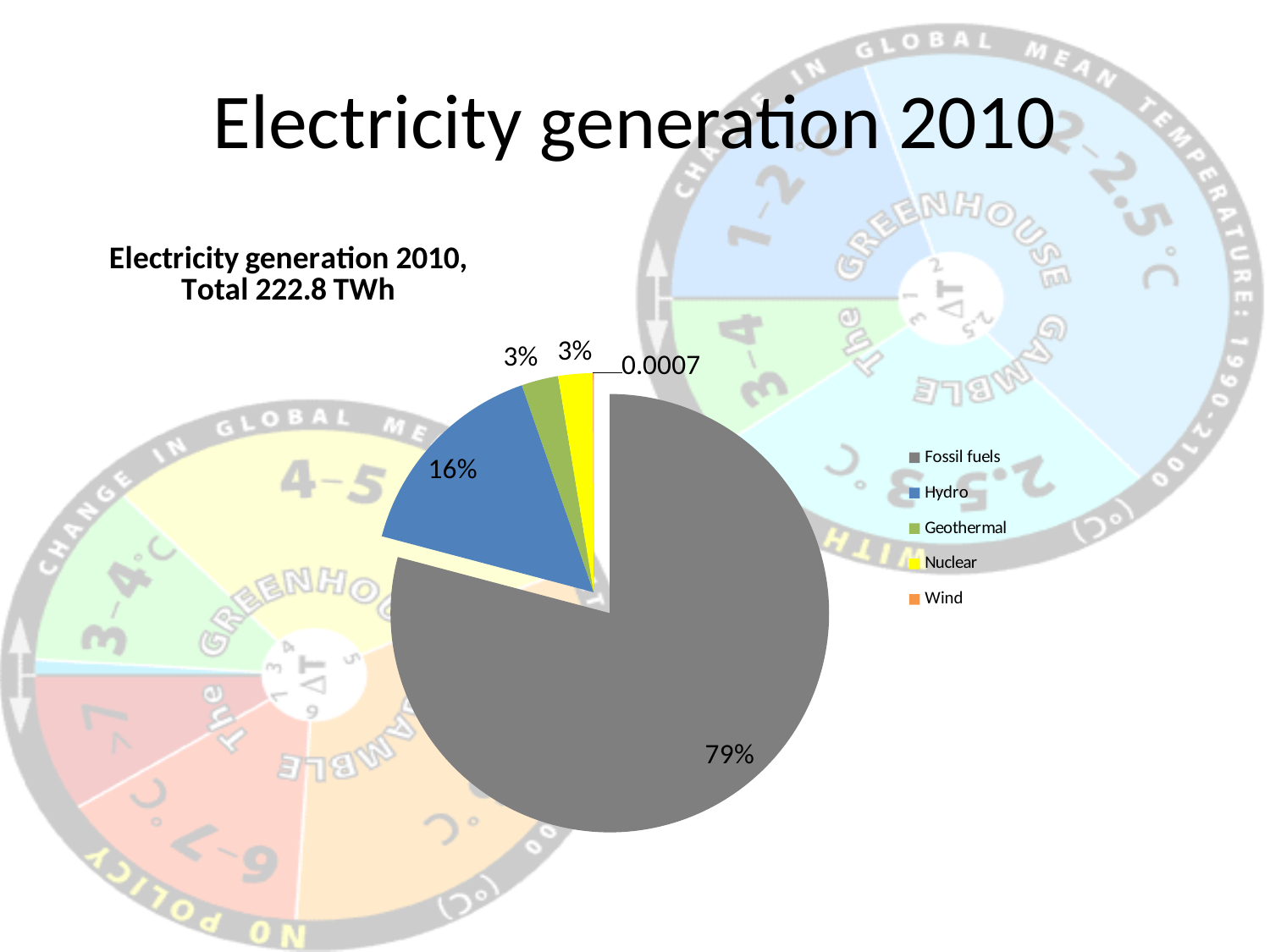
Which is larger, the Hydro share or the Nuclear share? Hydro What share of electricity generation comes from Fossil fuels? 79% How many percentage points larger is the Fossil fuels share than the Hydro share? 63 What is the chart's title? Electricity generation 2010, Total 222.8 TWh What share of electricity generation comes from Hydro? 16% What colour is the Nuclear slice? yellow Which source has the smallest share of electricity generation? Wind How many sources does the legend list? 5 What share of electricity generation comes from Geothermal? 3% What value is labelled for the Wind slice? 0.0007 What kind of chart is shown on the slide? pie chart Which source has the largest share of electricity generation? Fossil fuels